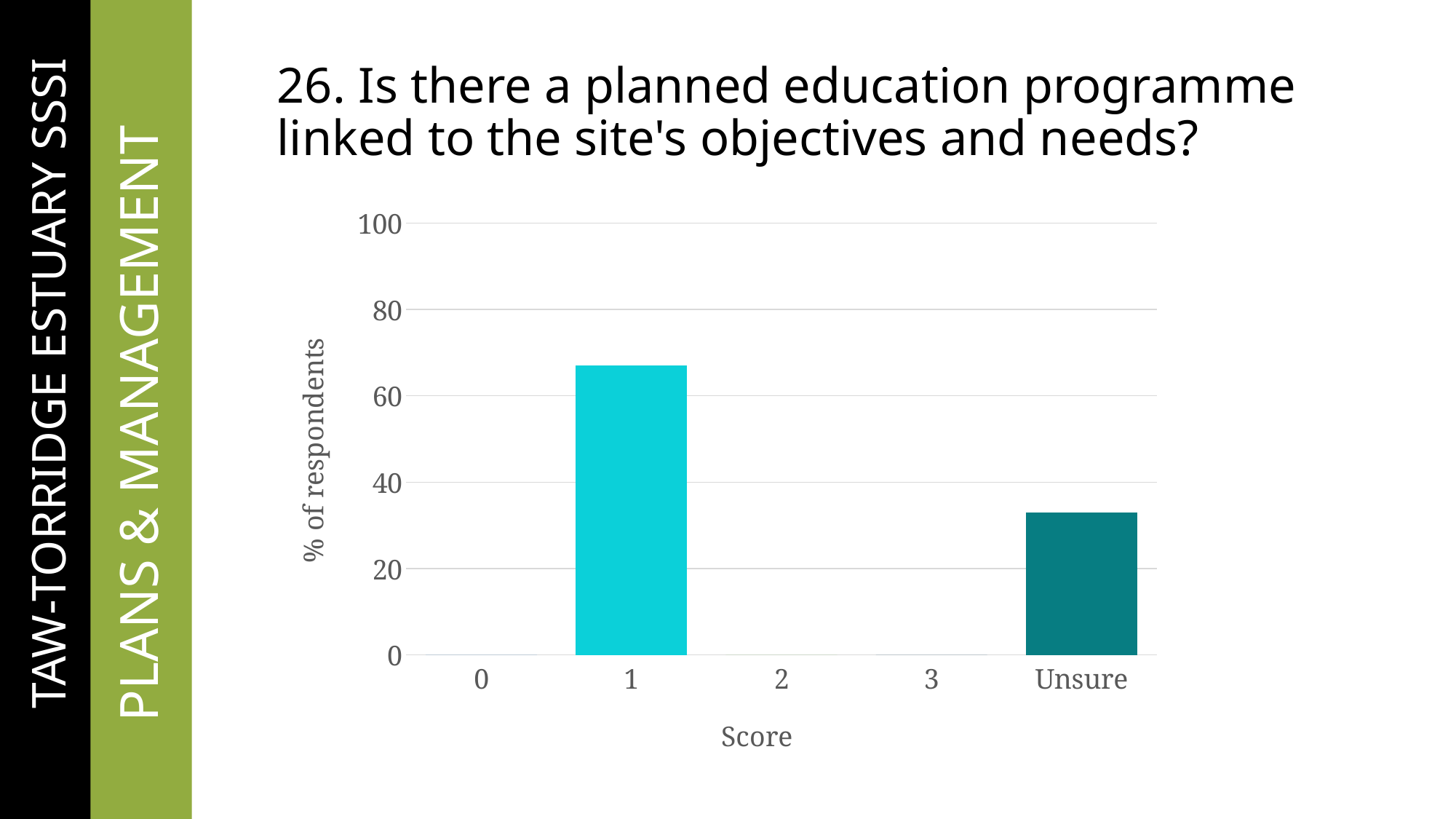
What type of chart is shown on the slide? bar chart Is the value for Unsure greater or less than 40? less Which score categories have no visible bar in the chart? 0, 2 and 3 What is the label of the y axis? % of respondents Which has a larger percentage of respondents, score 1 or Unsure? 1 Is the value for score 1 greater or less than 60? greater What is the label of the x axis? Score How many categories are shown on the x axis of the chart? 5 Which score category has the highest percentage of respondents? 1 Is the value for Unsure greater or less than 20? greater